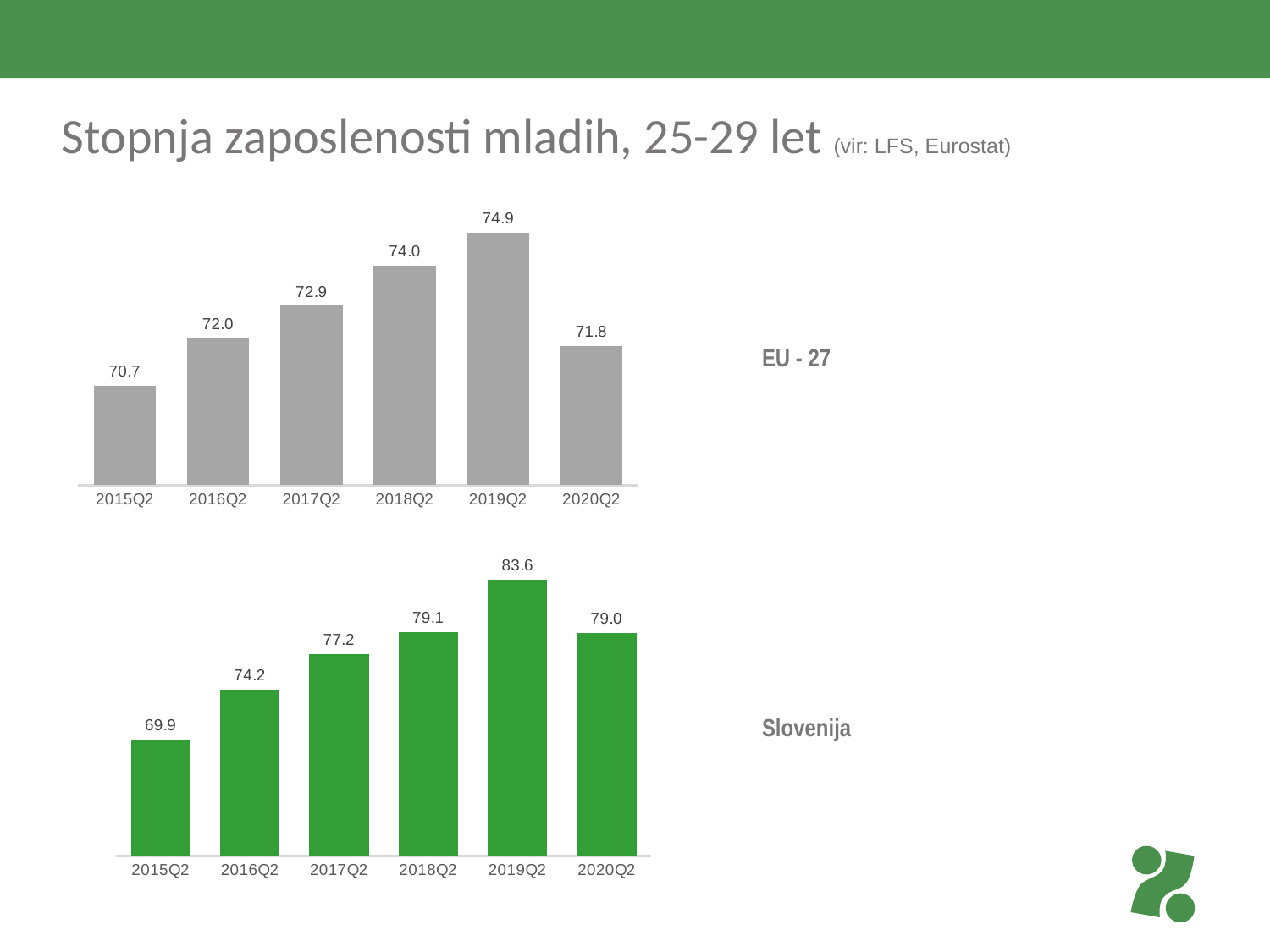
In the EU - 27 chart, what is the value for 2017Q2? 72.9 In the EU - 27 chart, which is larger, the value for 2016Q2 or the value for 2020Q2? 2016Q2 In the Slovenija chart, which is larger, the value for 2017Q2 or the value for 2020Q2? 2020Q2 In the Slovenija chart, what is the value for 2018Q2? 79.1 In the Slovenija chart, what is the difference between the values for 2019Q2 and 2020Q2? 4.6 In the EU - 27 chart, which quarter has the highest value? 2019Q2 What colour are the bars in the Slovenija chart? green In the EU - 27 chart, what is the difference between the values for 2015Q2 and 2019Q2? 4.2 In the Slovenija chart, which quarter has the lowest value? 2015Q2 What kind of chart is the Slovenija chart? bar chart How many quarters are shown in the EU - 27 chart? 6 In the EU - 27 chart, do the values rise or fall from 2015Q2 to 2019Q2? rise